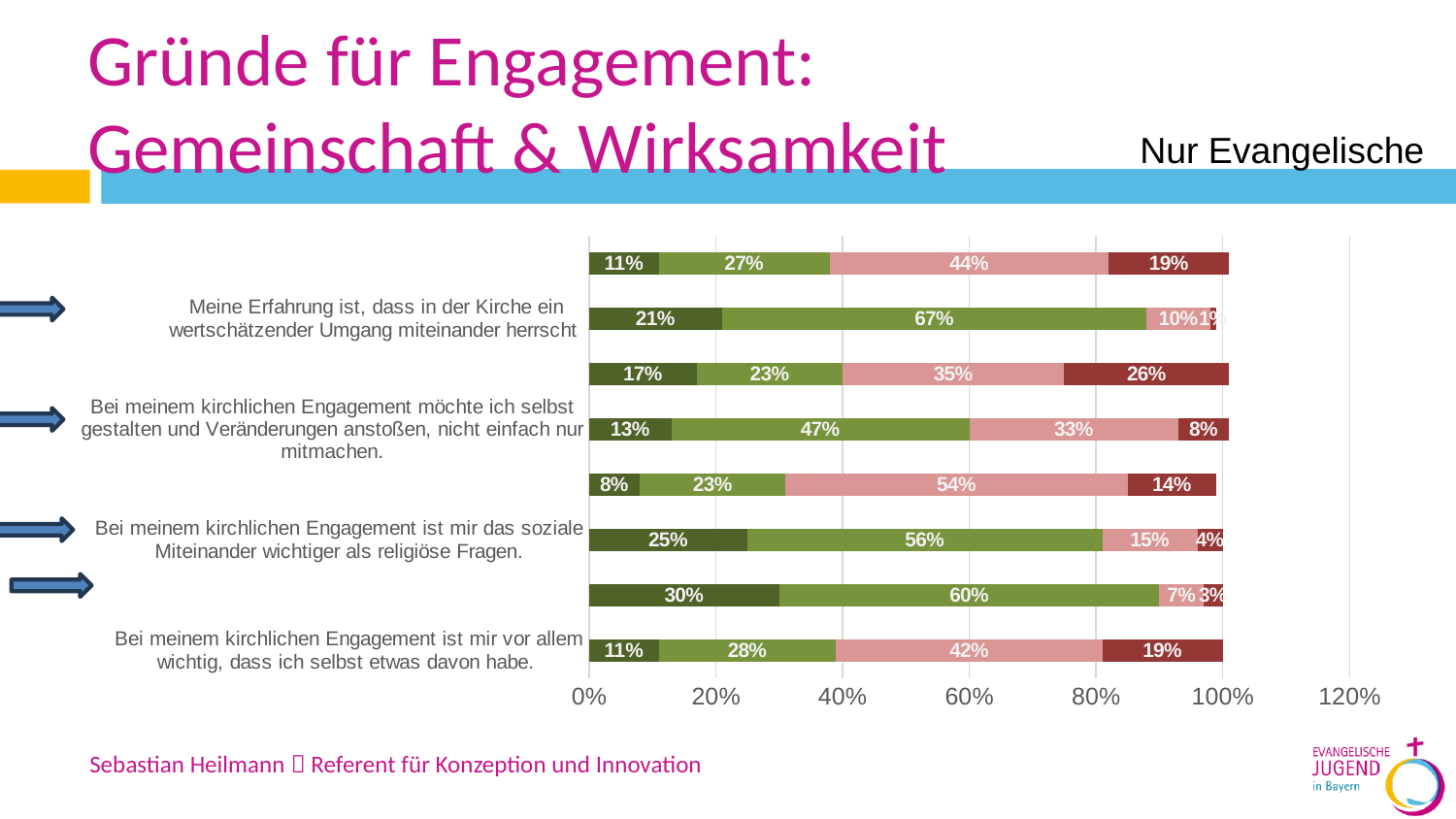
How many statements are listed as categories on the left of the chart? 4 How many bars are plotted in the chart? 8 What is the largest single segment value labelled anywhere in the chart? 67% What is the highest tick value shown on the x axis? 120% In the lower bar for 'Bei meinem kirchlichen Engagement ist mir vor allem wichtig, dass ich selbst etwas davon habe.', what is the value of the dark green segment? 11% What kind of chart is shown on the slide? Stacked horizontal bar chart What is the smallest single segment value labelled anywhere in the chart? 1% In the lower bar for 'Meine Erfahrung ist, dass in der Kirche ein wertschätzender Umgang miteinander herrscht', what is the value of the light green segment? 67%